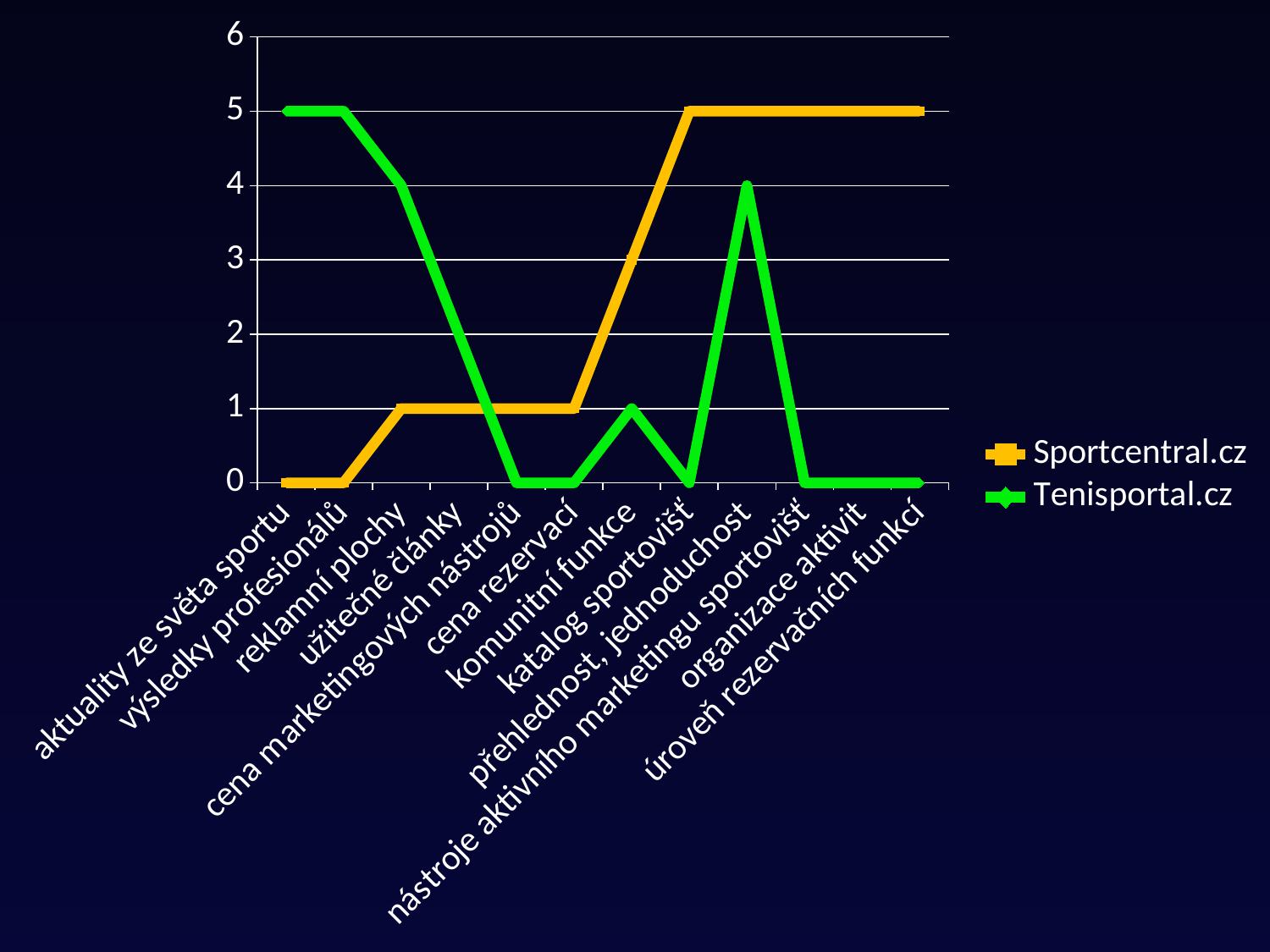
At organizace aktivit, which series has the higher value, Sportcentral.cz or Tenisportal.cz? Sportcentral.cz What is the value for Tenisportal.cz at aktuality ze světa sportu? 5 What is the difference between Sportcentral.cz and Tenisportal.cz at úroveň rezervačních funkcí? 5 At výsledky profesionálů, which series has the higher value, Sportcentral.cz or Tenisportal.cz? Tenisportal.cz What is the value for Sportcentral.cz at reklamní plochy? 1 What is the value for Sportcentral.cz at katalog sportovišť? 5 How many categories are shown on the x axis? 12 What kind of chart is shown on the slide? line chart What colour is the line for Tenisportal.cz? green What is the value for Tenisportal.cz at přehlednost, jednoduchost? 4 How many series does the legend list? 2 What is the value for Tenisportal.cz at komunitní funkce? 1